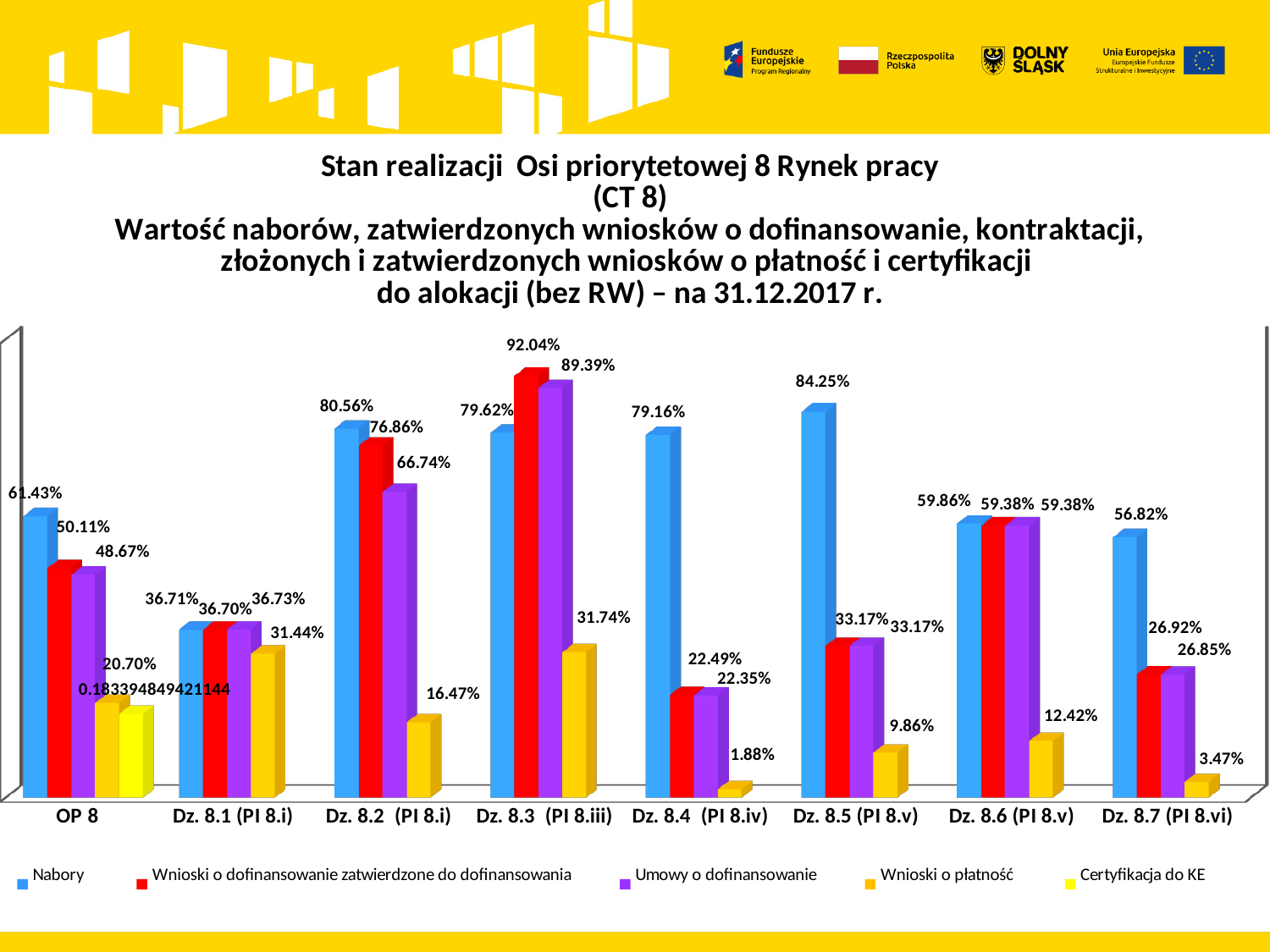
What is the value of Wnioski o płatność for Dz. 8.6 (PI 8.v)? 12.42% How many series does the legend list? 5 What is the value of Umowy o dofinansowanie for Dz. 8.7 (PI 8.vi)? 26.85% Which category has the lowest Wnioski o płatność value? Dz. 8.4 (PI 8.iv) For Dz. 8.3 (PI 8.iii), which is larger: Nabory or Wnioski o dofinansowanie zatwierdzone do dofinansowania? Wnioski o dofinansowanie zatwierdzone do dofinansowania What is the value of Wnioski o płatność for Dz. 8.4 (PI 8.iv)? 1.88% Which category has the highest Nabory value? Dz. 8.5 (PI 8.v) How many categories are shown on the x axis? 8 What is the value of Nabory for Dz. 8.5 (PI 8.v)? 84.25% What is the highest value shown anywhere on the chart? 92.04% What kind of chart is shown on the slide? Bar chart For Dz. 8.2 (PI 8.i), what is the difference between the Nabory value and the Wnioski o płatność value? 64.09 percentage points